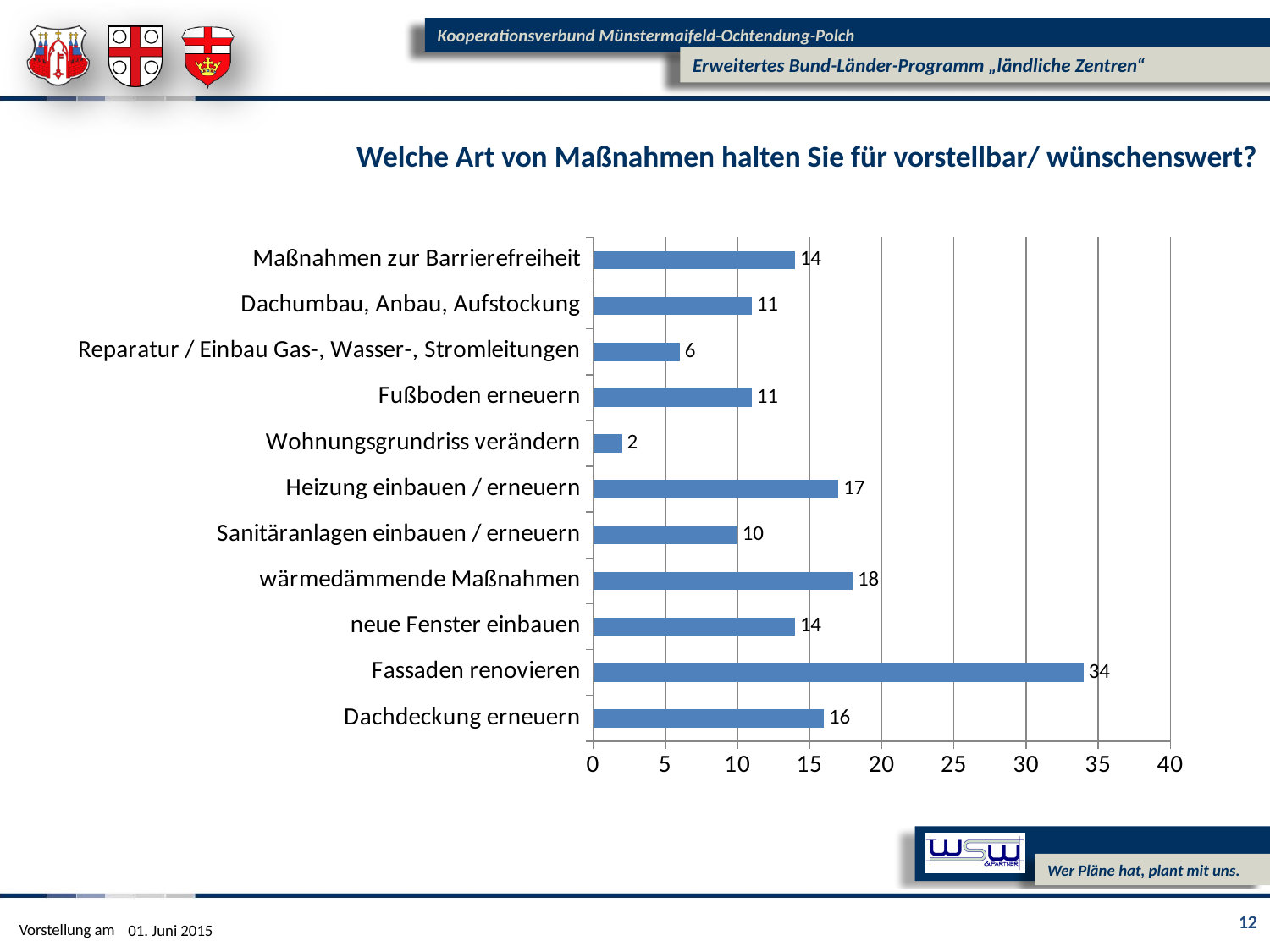
What is the value for "Fassaden renovieren"? 34 What is the difference between "Fassaden renovieren" and "wärmedämmende Maßnahmen"? 16 How many categories are shown in the chart? 11 What is the title of the chart? Welche Art von Maßnahmen halten Sie für vorstellbar/ wünschenswert? Is the value for "Sanitäranlagen einbauen / erneuern" greater or less than 15? less Which is larger, "Dachdeckung erneuern" or "neue Fenster einbauen"? Dachdeckung erneuern What is the value for "Heizung einbauen / erneuern"? 17 Which category has the highest value? Fassaden renovieren What kind of chart is shown on the slide? bar chart Which category has the lowest value? Wohnungsgrundriss verändern What is the value for "Reparatur / Einbau Gas-, Wasser-, Stromleitungen"? 6 What is the value for "Wohnungsgrundriss verändern"? 2